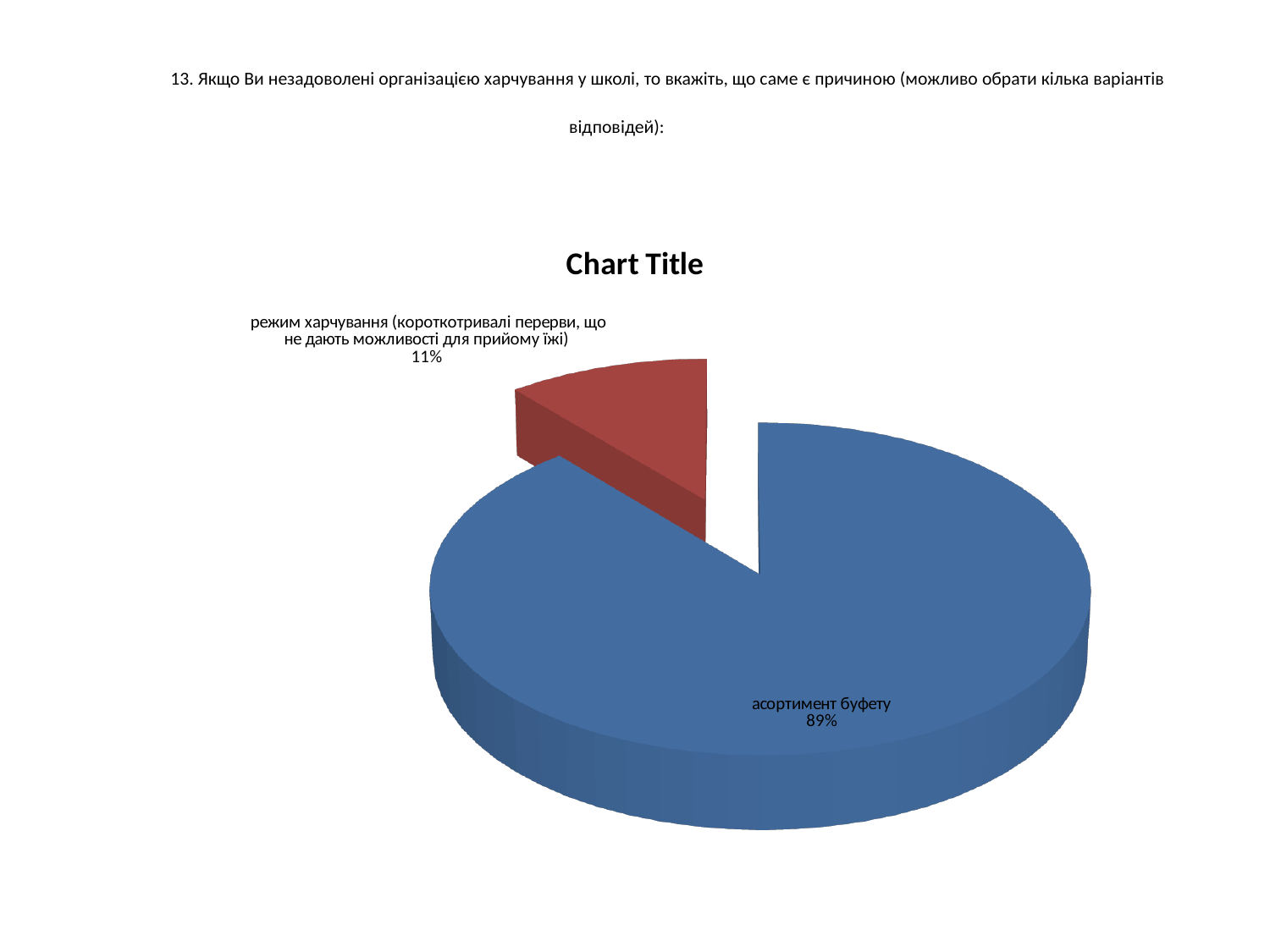
What is the title shown above the pie chart? Chart Title Which category has the smallest slice of the pie? режим харчування (короткотривалі перерви, що не дають можливості для прийому їжі) What kind of chart is shown on the slide? pie chart What colour is the "асортимент буфету" slice? blue Which category has the largest slice of the pie? асортимент буфету What is the difference in percentage points between the "асортимент буфету" slice and the "режим харчування" slice? 78 What share of the pie does "асортимент буфету" have? 89% How many slices does the pie chart have? 2 What share of the pie does "режим харчування (короткотривалі перерви, що не дають можливості для прийому їжі)" have? 11% Which is larger: the share for "асортимент буфету" or the share for "режим харчування"? асортимент буфету